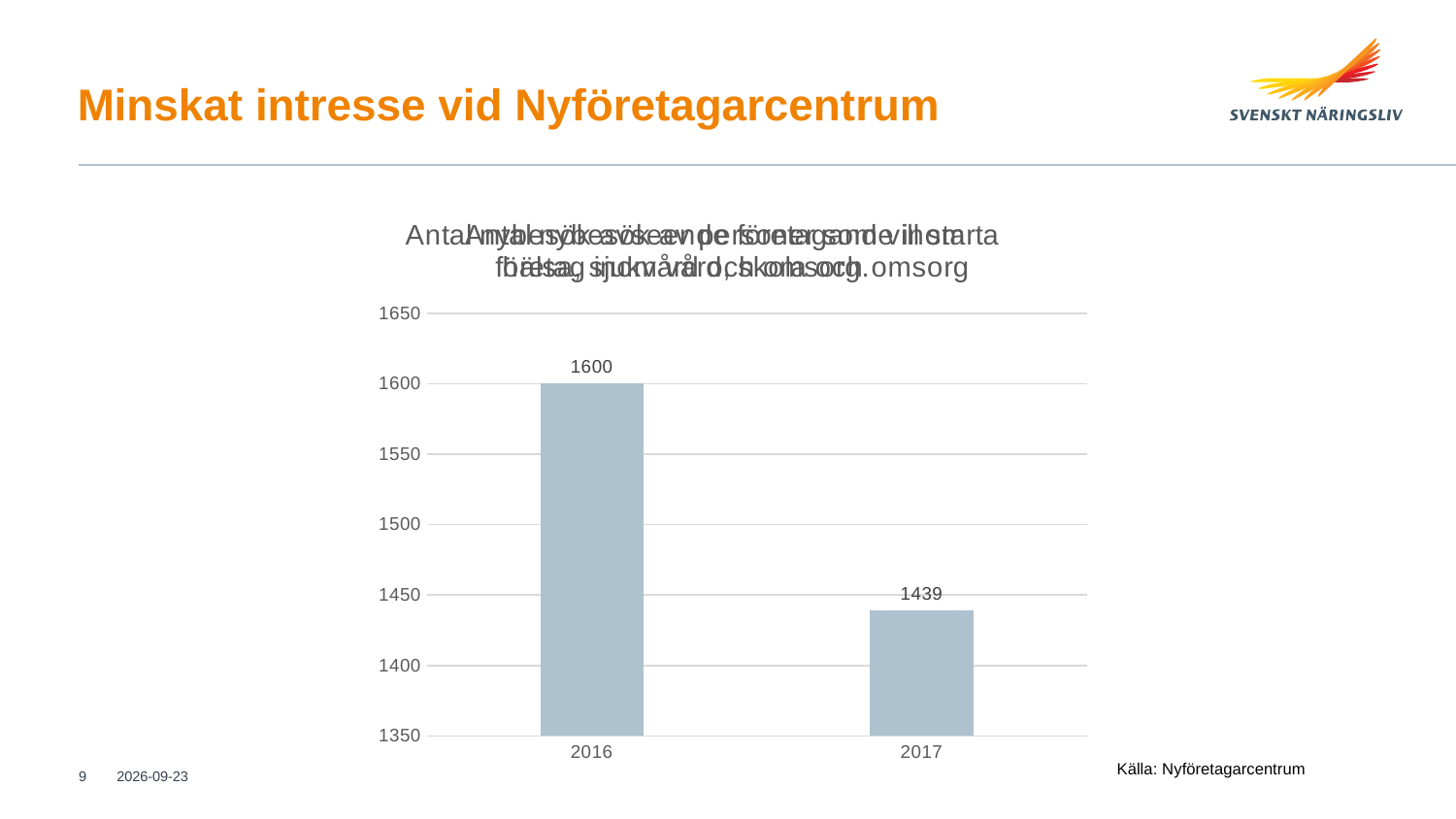
What kind of chart is shown on the slide? bar chart How many years are shown on the x axis? 2 Which is larger, the value for 2016 or the value for 2017? 2016 What is the difference between the values for 2016 and 2017? 161 Is the value for 2016 greater or less than 1550? greater Do the values rise or fall from 2016 to 2017? fall Which year has the highest value? 2016 Is the value for 2017 greater or less than 1450? less What source is cited below the chart? Källa: Nyföretagarcentrum What is the value for 2017? 1439 Which year has the lowest value? 2017 What is the value for 2016? 1600